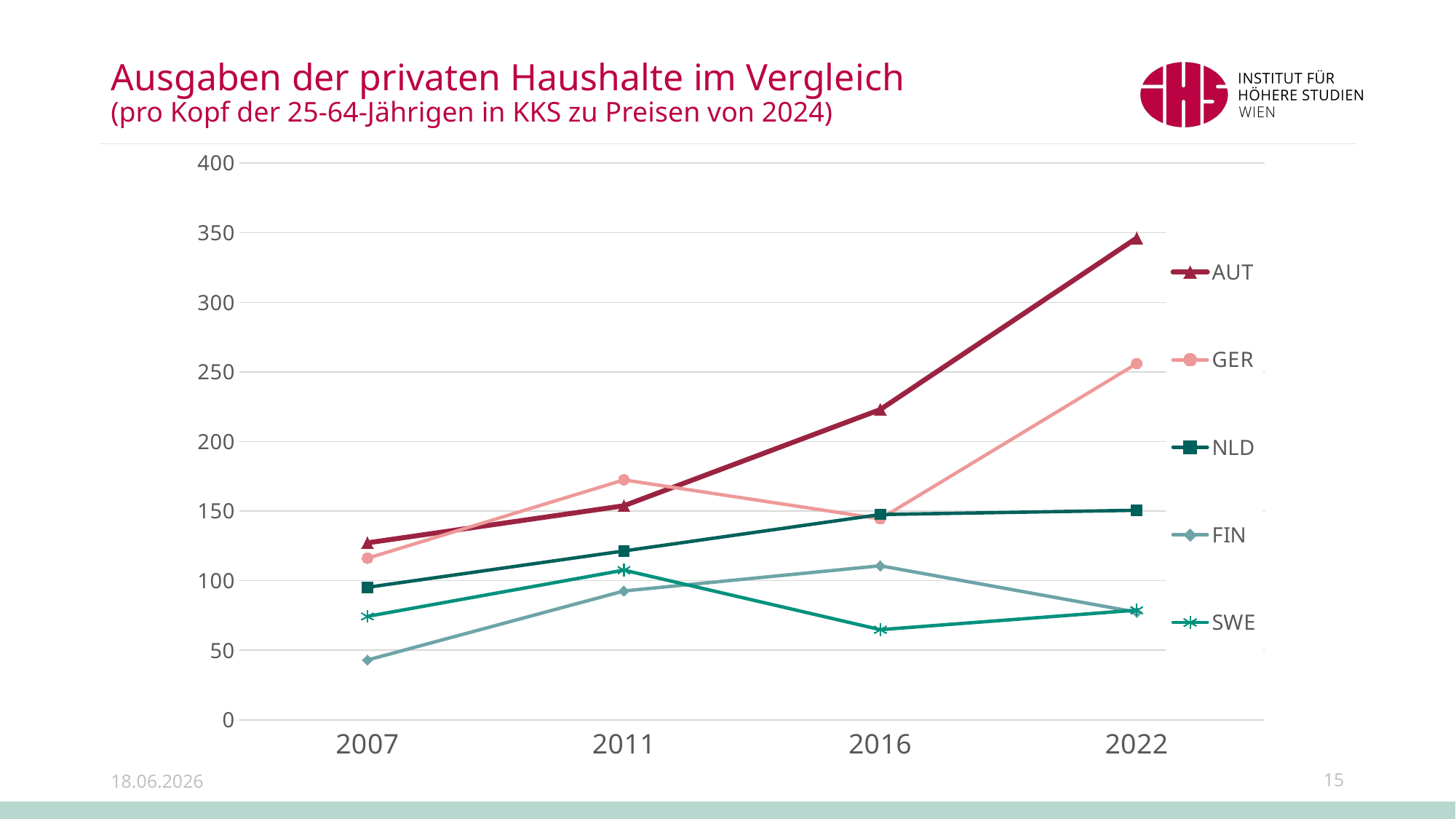
Is the value for GER in 2011 greater or less than 150? greater Which country has the highest value in 2007? AUT Is the value for SWE in 2016 greater or less than 100? less Is the value for AUT in 2022 greater or less than 300? greater Does the AUT line rise or fall from 2007 to 2022? rise How many years are shown on the x axis? 4 Which country has the highest value in 2022? AUT Which series is drawn with a triangle marker in the legend? AUT How many series does the legend list? 5 In 2011, which is higher: GER or AUT? GER What kind of chart is shown on the slide? line chart Which country has the lowest value in 2007? FIN